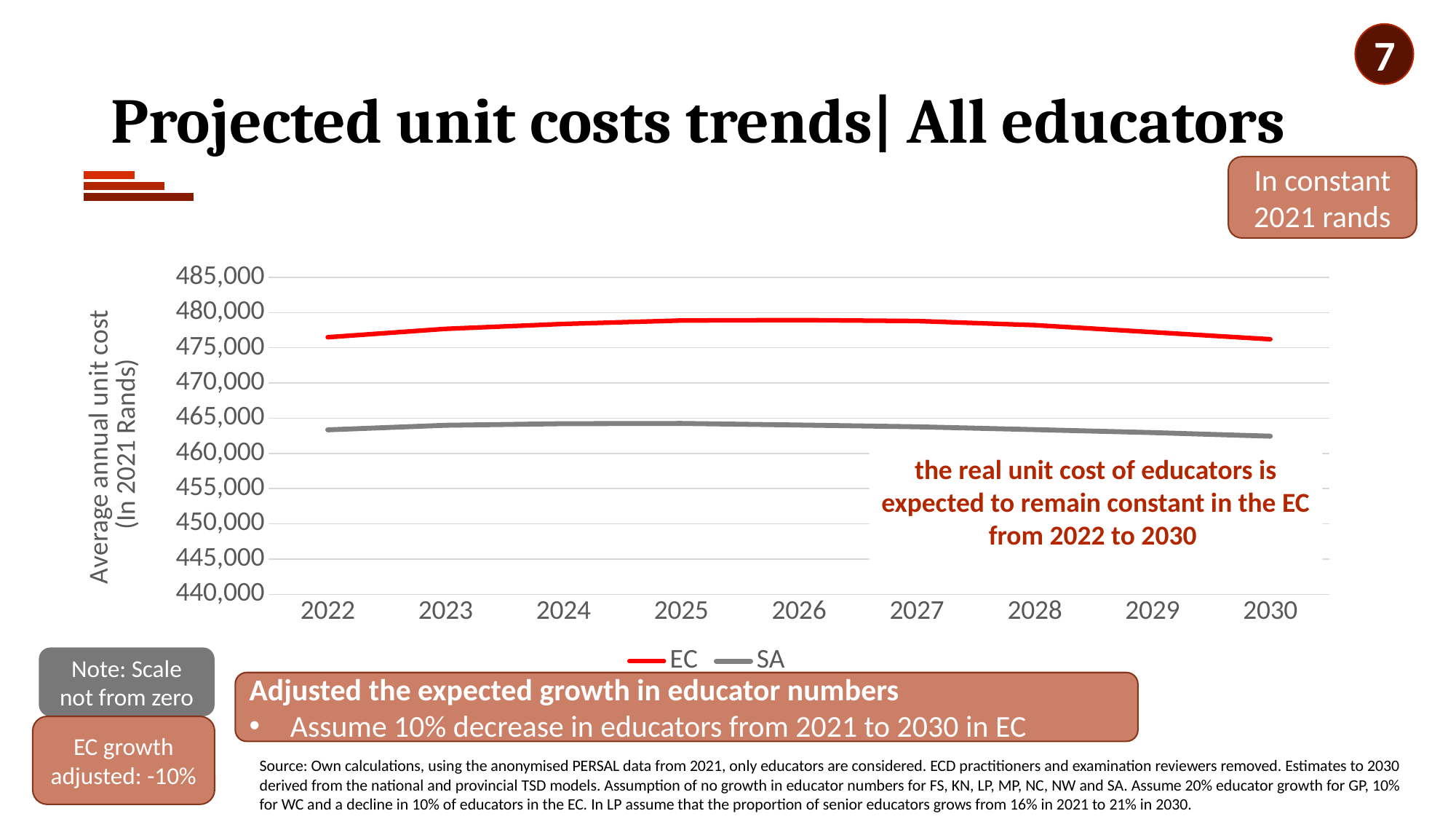
What colour is the EC line in the chart? red Is the value for SA in 2022 greater or less than 465,000? less What is the y-axis title of the chart? Average annual unit cost (In 2021 Rands) Is the value for EC in 2026 greater or less than 475,000? greater Which series has the higher unit cost in 2022, EC or SA? EC Which series has the higher unit cost in 2030, EC or SA? EC How many series does the chart legend list? 2 Is the value for SA in 2030 greater or less than 460,000? greater Does the EC line rise or fall between 2022 and 2025? rise What kind of chart is shown on the slide? line chart Does the EC line rise or fall between 2026 and 2030? fall How many years are plotted along the x axis of the chart? 9